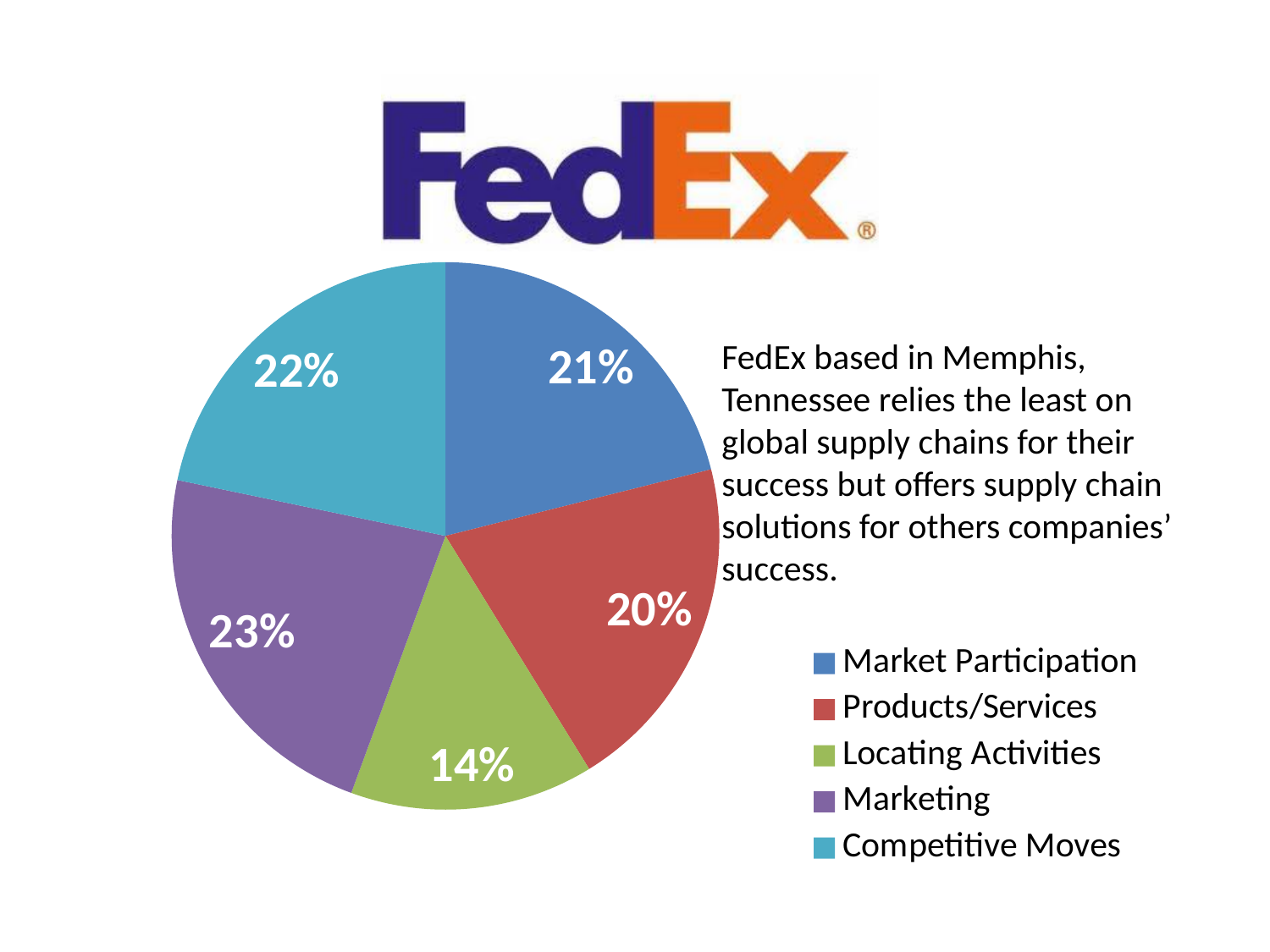
Which is larger, the slice for Competitive Moves or the slice for Products/Services? Competitive Moves How many categories does the pie chart show? 5 What share of the pie does Locating Activities have? 14% What share of the pie does Competitive Moves have? 22% What colour is the Locating Activities slice? green What share of the pie does Products/Services have? 20% Which category has the largest slice of the pie? Marketing Which category has the smallest slice of the pie? Locating Activities What type of chart is shown on the slide? pie chart What is the difference in percentage points between Marketing and Locating Activities? 9